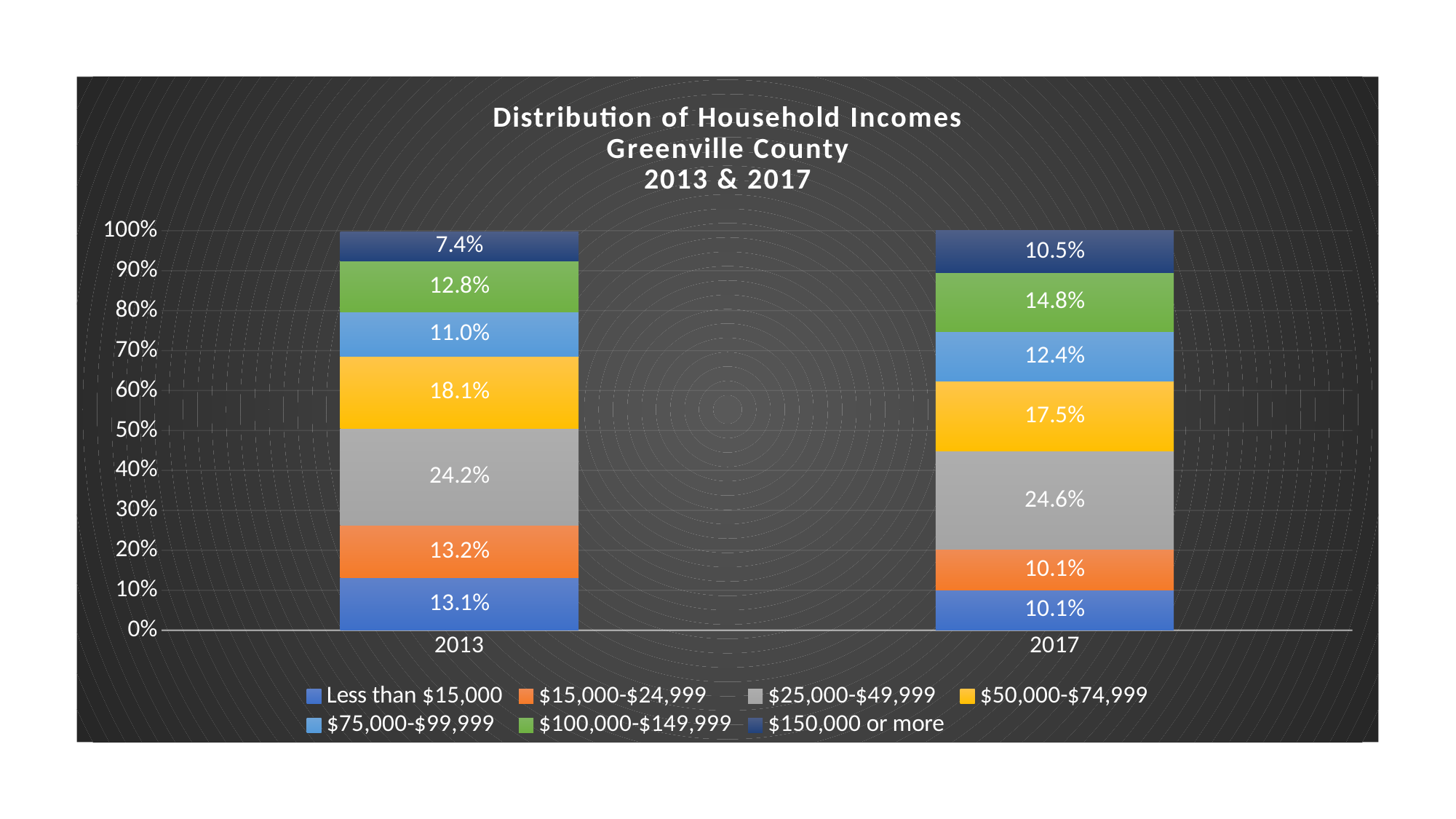
Which income bracket has the smallest share in the 2013 bar? $150,000 or more What share of households in 2013 had incomes of $25,000-$49,999? 24.2% By how many percentage points did the $150,000 or more share change from 2013 to 2017? 3.1 percentage points How many years (bars) are shown on the chart? 2 Which income bracket has the largest share in the 2017 bar? $25,000-$49,999 What type of chart is shown on the slide? Stacked bar chart What percentage of households earned less than $15,000 in 2013? 13.1% Is the $75,000-$99,999 share larger in 2013 or in 2017? 2017 How many income brackets does the legend list? 7 What is the difference between the $15,000-$24,999 share in 2013 and in 2017? 3.1 percentage points What is the value for $150,000 or more in 2017? 10.5% What is the value for $100,000-$149,999 in 2017? 14.8%